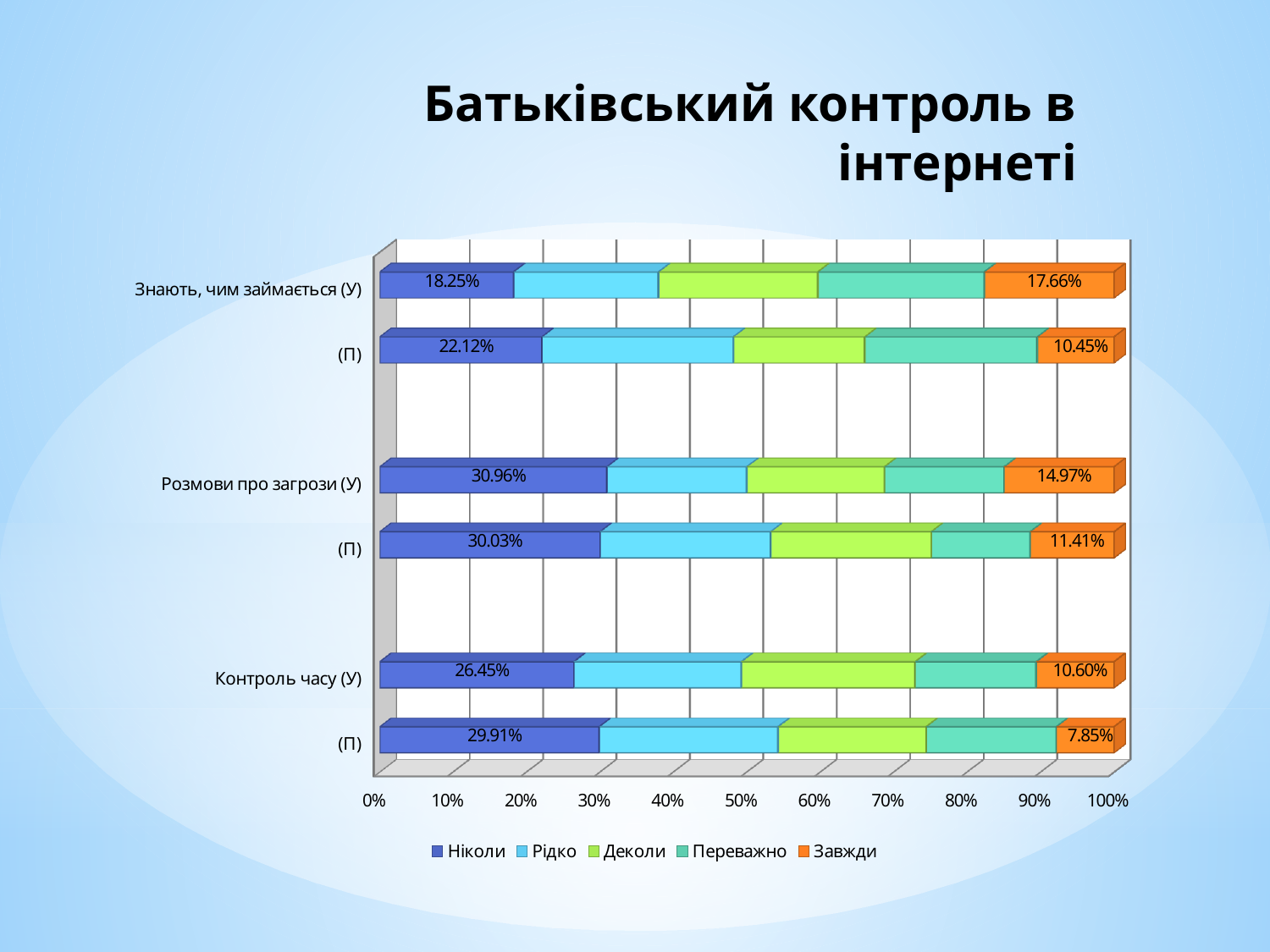
What kind of chart is shown on the slide? Stacked bar chart Which is larger: the "Завжди" value for "Контроль часу (У)" or for "Контроль часу (П)"? Контроль часу (У) How many series does the legend list? 5 How many bars are plotted in the chart? 6 What is the value of the "Ніколи" segment for the "(П)" bar under "Контроль часу"? 29.91% Which bar has the highest "Завжди" value? Знають, чим займається (У) Which bar has the highest "Ніколи" value? Розмови про загрози (У) Which bar has the lowest "Завжди" value? Контроль часу (П) What is the value of the "Завжди" segment for the "(П)" bar under "Знають, чим займається"? 10.45% What is the difference between the "Ніколи" values for "Розмови про загрози (У)" and its "(П)" bar? 0.93% What is the value of the "Ніколи" segment for "Знають, чим займається (У)"? 18.25% What is the value of the "Завжди" segment for "Розмови про загрози (У)"? 14.97%